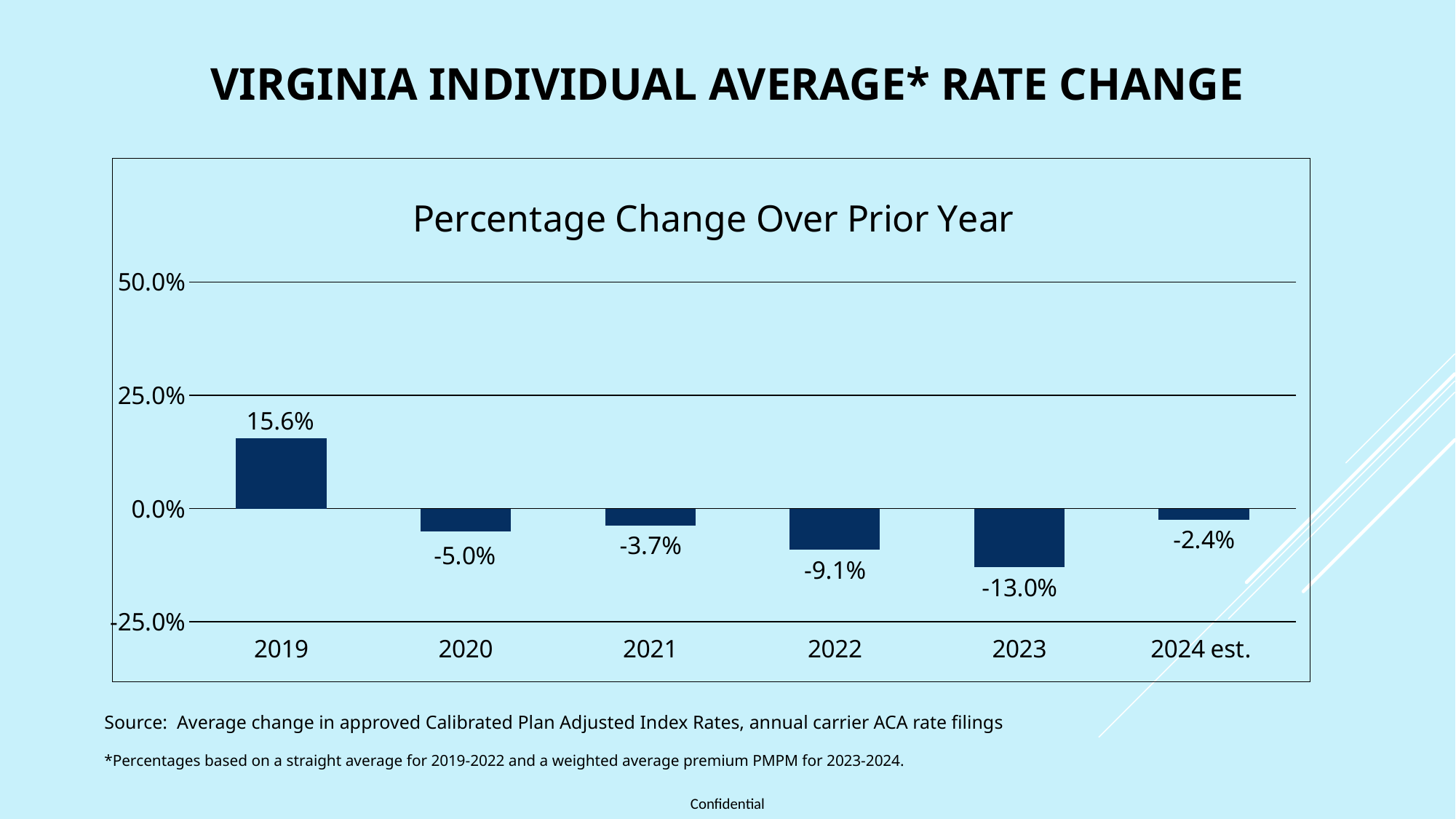
What is the title of the chart? Percentage Change Over Prior Year What is the difference between the 2019 value and the 2023 value? 28.6 percentage points What is the percentage change for 2024 est.? -2.4% What is the percentage change for 2022? -9.1% Is the value for 2019 greater or less than 25.0%? less Which is larger, the value for 2020 or the value for 2021? 2021 Which year has the highest percentage change? 2019 What kind of chart is this? Bar chart How many years show a negative percentage change? 5 Which year has the lowest percentage change? 2023 How many years are shown on the x axis? 6 What is the percentage change for 2019? 15.6%